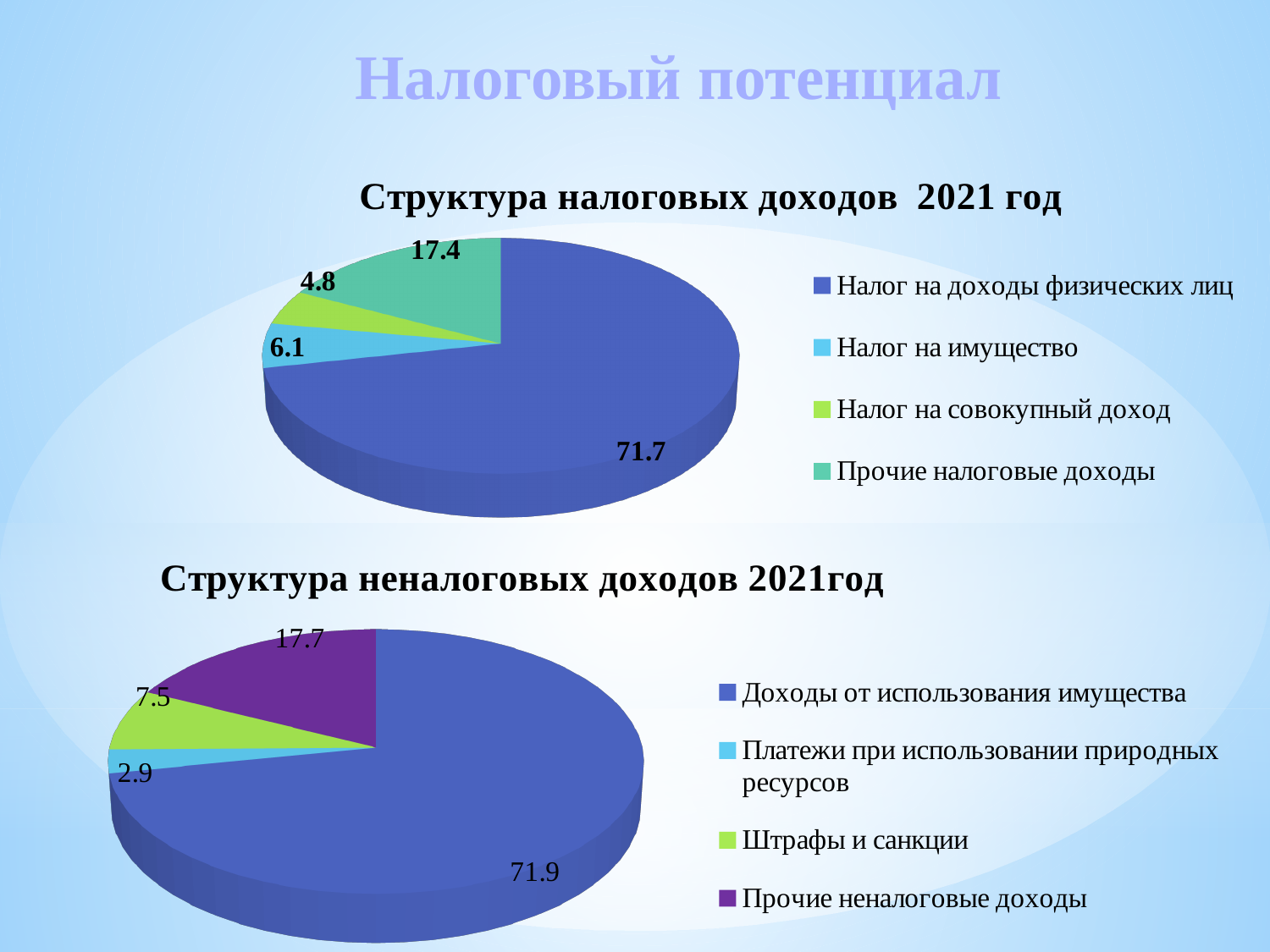
In the chart 'Структура налоговых доходов 2021 год', what is the difference between 'Налог на имущество' and 'Налог на совокупный доход'? 1.3 In the chart 'Структура налоговых доходов 2021 год', what is the value for 'Прочие налоговые доходы'? 17.4 In the chart 'Структура неналоговых доходов 2021год', what is the value for 'Платежи при использовании природных ресурсов'? 2.9 In the chart 'Структура налоговых доходов 2021 год', what is the value for 'Налог на доходы физических лиц'? 71.7 In the chart 'Структура налоговых доходов 2021 год', how many slices does the pie have? 4 In the chart 'Структура неналоговых доходов 2021год', which category has the largest slice? Доходы от использования имущества In the chart 'Структура неналоговых доходов 2021год', which is larger: 'Прочие неналоговые доходы' or 'Штрафы и санкции'? Прочие неналоговые доходы In the chart 'Структура неналоговых доходов 2021год', what is the difference between 'Прочие неналоговые доходы' and 'Платежи при использовании природных ресурсов'? 14.8 In the chart 'Структура неналоговых доходов 2021год', what is the value for 'Штрафы и санкции'? 7.5 In the chart 'Структура налоговых доходов 2021 год', which category has the smallest slice? Налог на совокупный доход In the chart 'Структура налоговых доходов 2021 год', what colour is the slice for 'Прочие налоговые доходы'? Teal (green-blue) What type of chart is 'Структура неналоговых доходов 2021год'? Pie chart